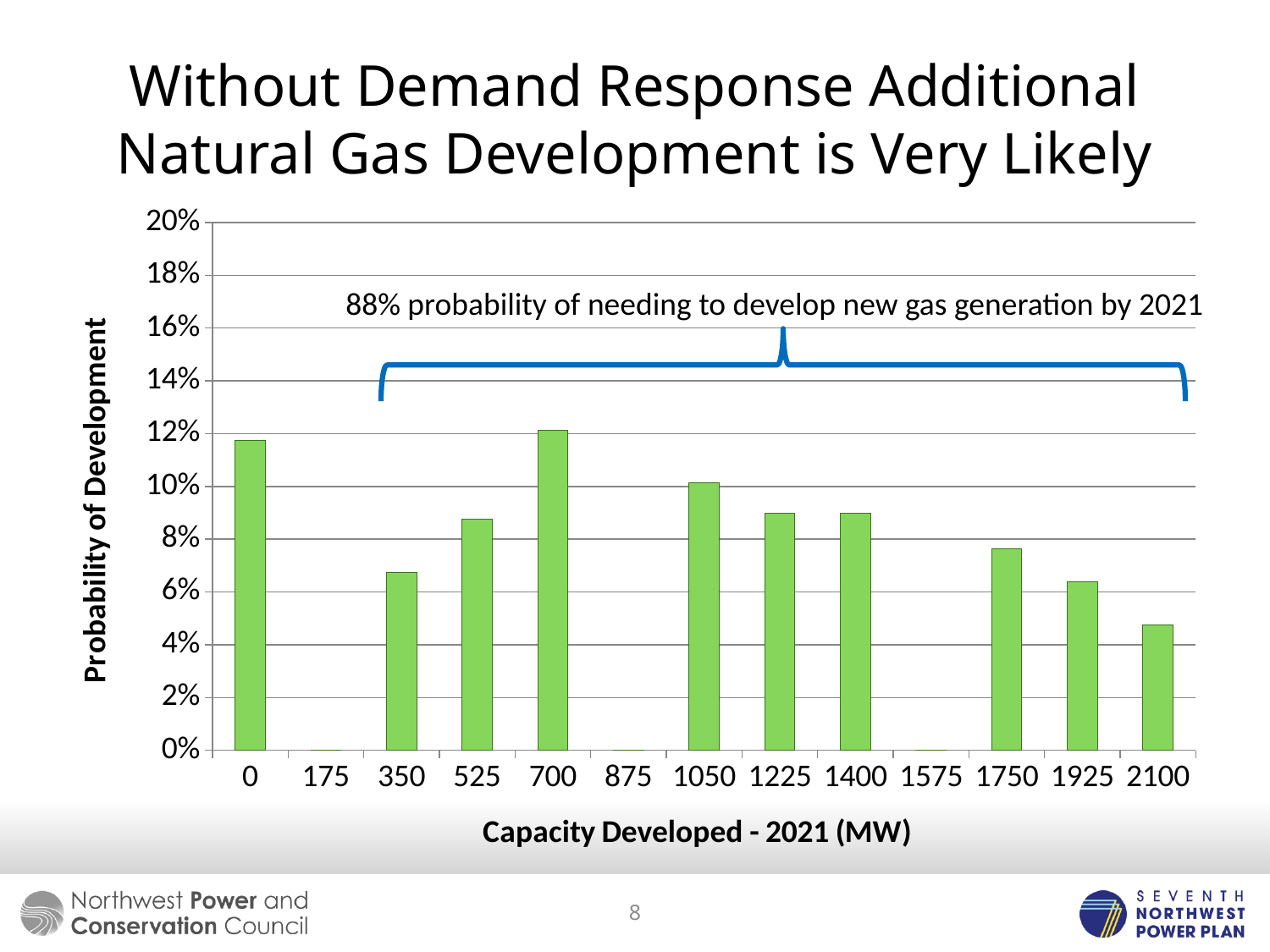
What is the title of the x axis? Capacity Developed - 2021 (MW) What probability of needing to develop new gas generation by 2021 does the annotation on the chart state? 88% How many capacity categories are shown on the x axis? 13 Do the probabilities rise or fall from 1750 MW to 2100 MW? fall Is the probability of development for 700 MW greater or less than 10%? greater Is the probability of development for 0 MW greater or less than 10%? greater Is the probability of development for 350 MW greater or less than 8%? less What kind of chart is shown on the slide? bar chart Which has a higher probability of development, 525 MW or 2100 MW? 525 MW Which has a higher probability of development, 0 MW or 350 MW? 0 MW